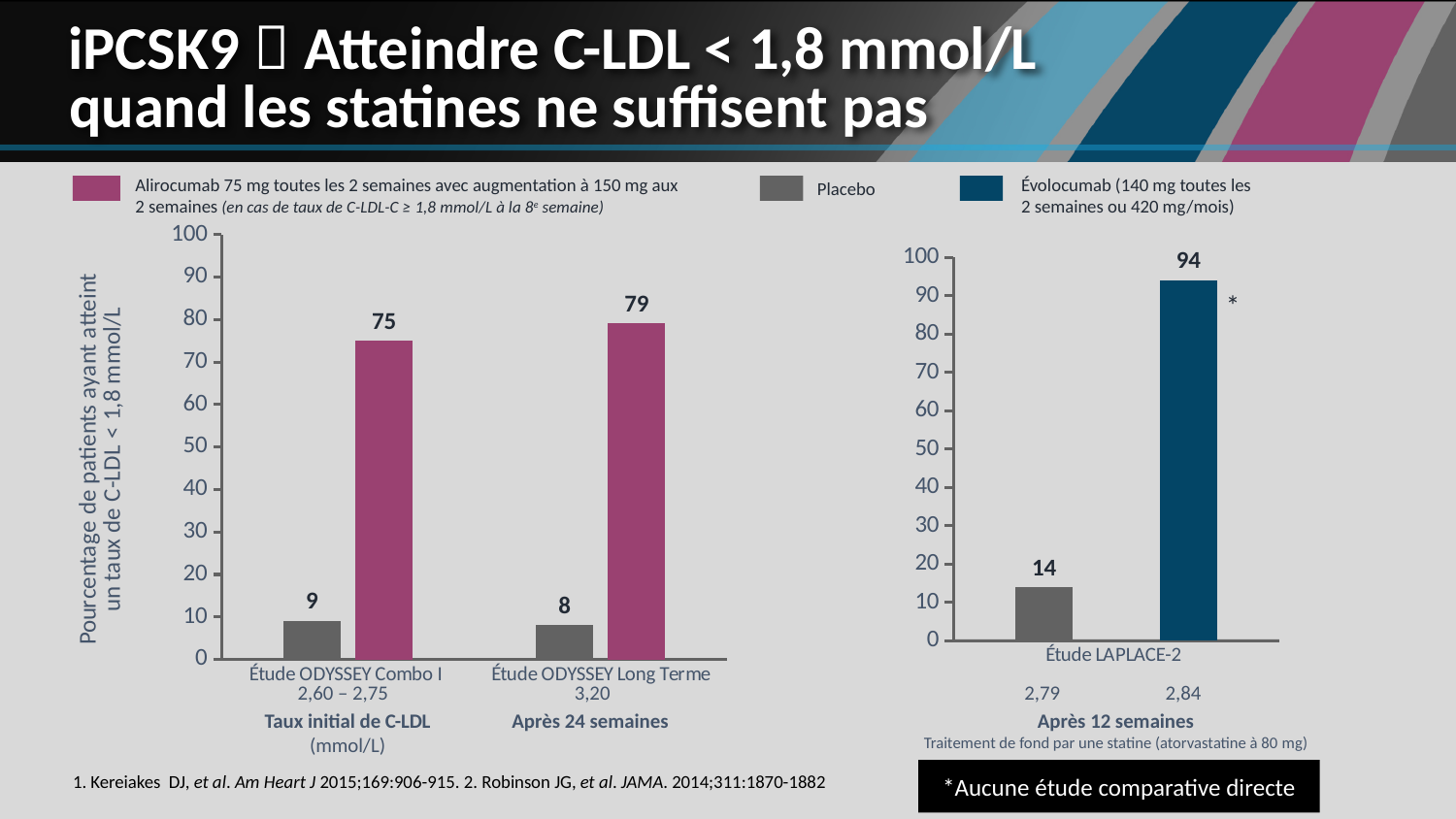
In the right chart (Étude LAPLACE-2), what is the value for évolocumab? 94 In the right chart (Étude LAPLACE-2), what is the value for placebo? 14 What is the y-axis label of the left chart? Pourcentage de patients ayant atteint un taux de C-LDL < 1,8 mmol/L In the left chart, which study has the higher alirocumab value, Étude ODYSSEY Combo I or Étude ODYSSEY Long Terme? Étude ODYSSEY Long Terme How many study categories are shown on the x axis of the left chart? 2 In the left chart, what is the value for placebo in Étude ODYSSEY Long Terme? 8 In the left chart, which bar is the lowest? Placebo in Étude ODYSSEY Long Terme (8) What type of chart is the left chart? Bar chart In the right chart (Étude LAPLACE-2), what is the difference between the évolocumab and placebo values? 80 In the left chart, what is the value for alirocumab in Étude ODYSSEY Combo I? 75 In the left chart, what is the difference between the alirocumab and placebo values in Étude ODYSSEY Long Terme? 71 In the right chart (Étude LAPLACE-2), is the value for évolocumab greater or less than 90? greater